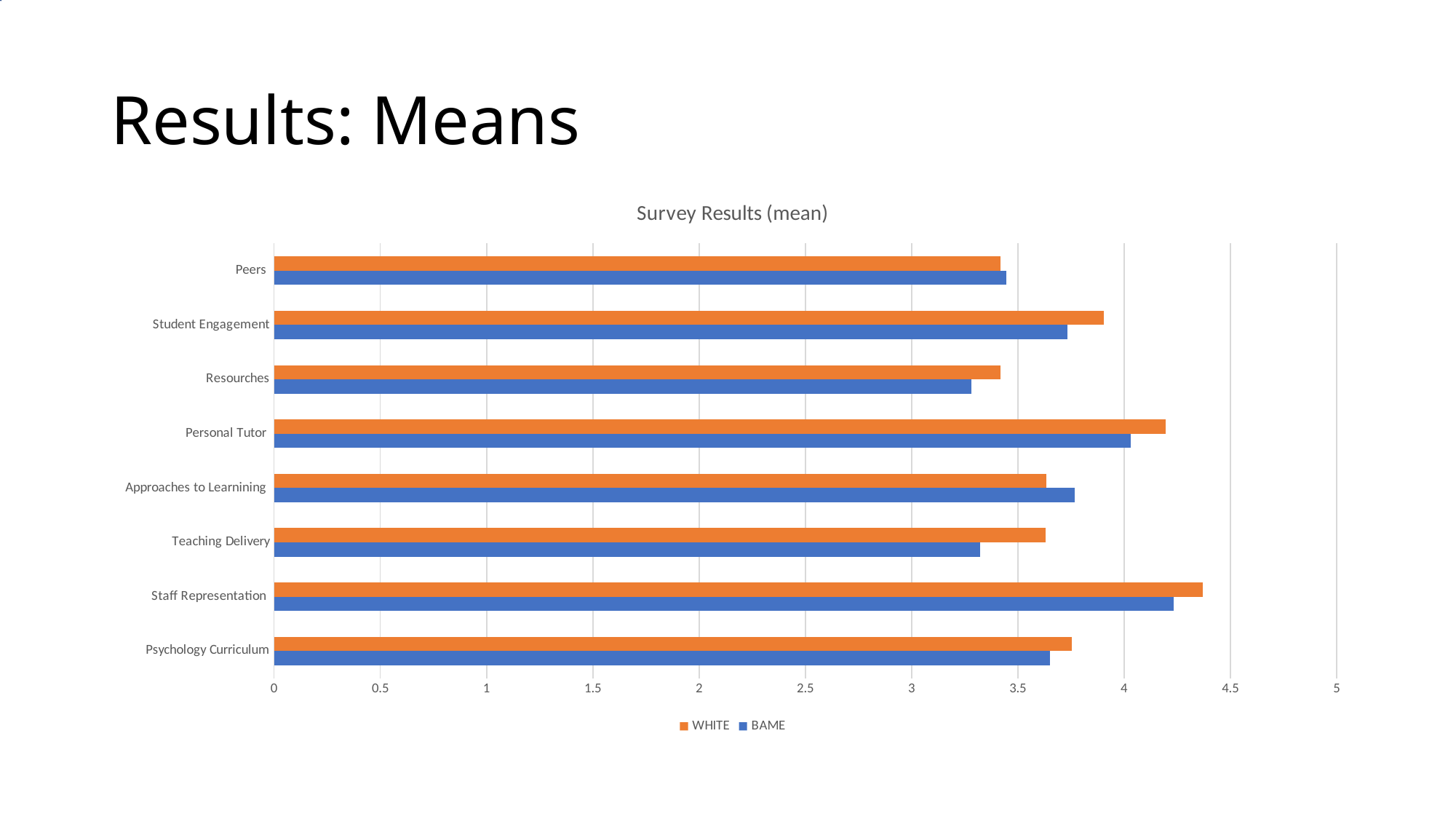
For Approaches to Learning, which series has the larger value, WHITE or BAME? BAME What is the title of the chart? Survey Results (mean) Which colour represents the BAME series in the chart? blue Which category has the highest BAME value? Staff Representation Is the WHITE value for Staff Representation greater or less than 4? greater For Teaching Delivery, which series has the larger value, WHITE or BAME? WHITE Is the BAME value for Teaching Delivery greater or less than 3.5? less What kind of chart is shown on the slide? bar chart Which category has the highest WHITE value? Staff Representation How many categories are shown on the chart? 8 Is the WHITE value for Student Engagement greater or less than 3.5? greater How many series does the legend list? 2